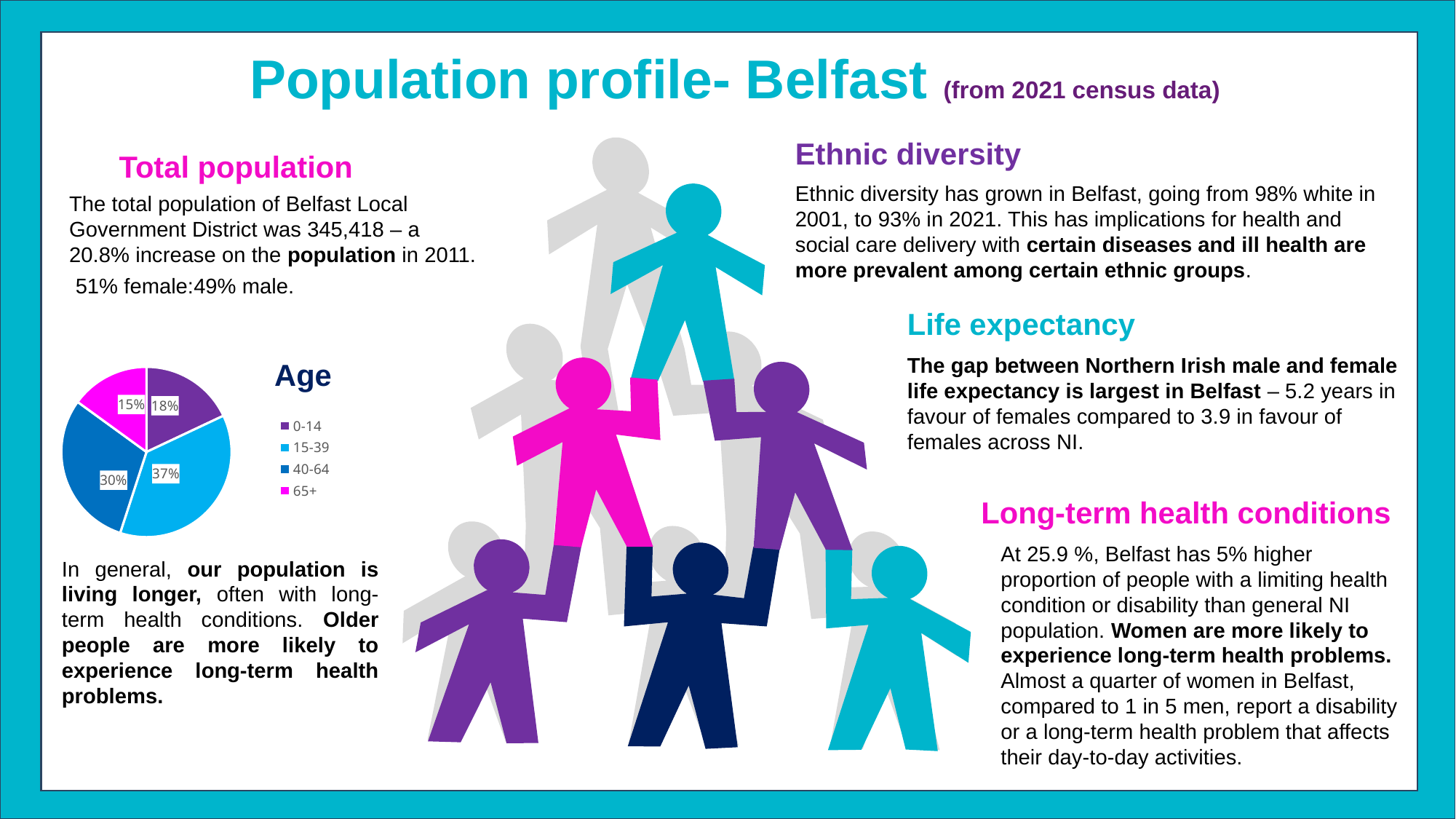
What kind of chart is the Age chart? pie chart In the Age pie chart, what share of the population is aged 15-39? 37% How many entries does the legend of the Age pie chart list? 4 Which age group has the smallest slice in the Age pie chart? 65+ Which age group has the largest slice in the Age pie chart? 15-39 What colour is the 65+ slice in the Age pie chart? magenta In the Age pie chart, what share of the population is aged 0-14? 18% In the Age pie chart, which slice is larger: 0-14 or 65+? 0-14 In the Age pie chart, what share of the population is aged 40-64? 30% In the Age pie chart, what is the difference in percentage points between the 15-39 and 40-64 slices? 7 How many age groups are shown in the Age pie chart? 4 In the Age pie chart, what share of the population is aged 65+? 15%